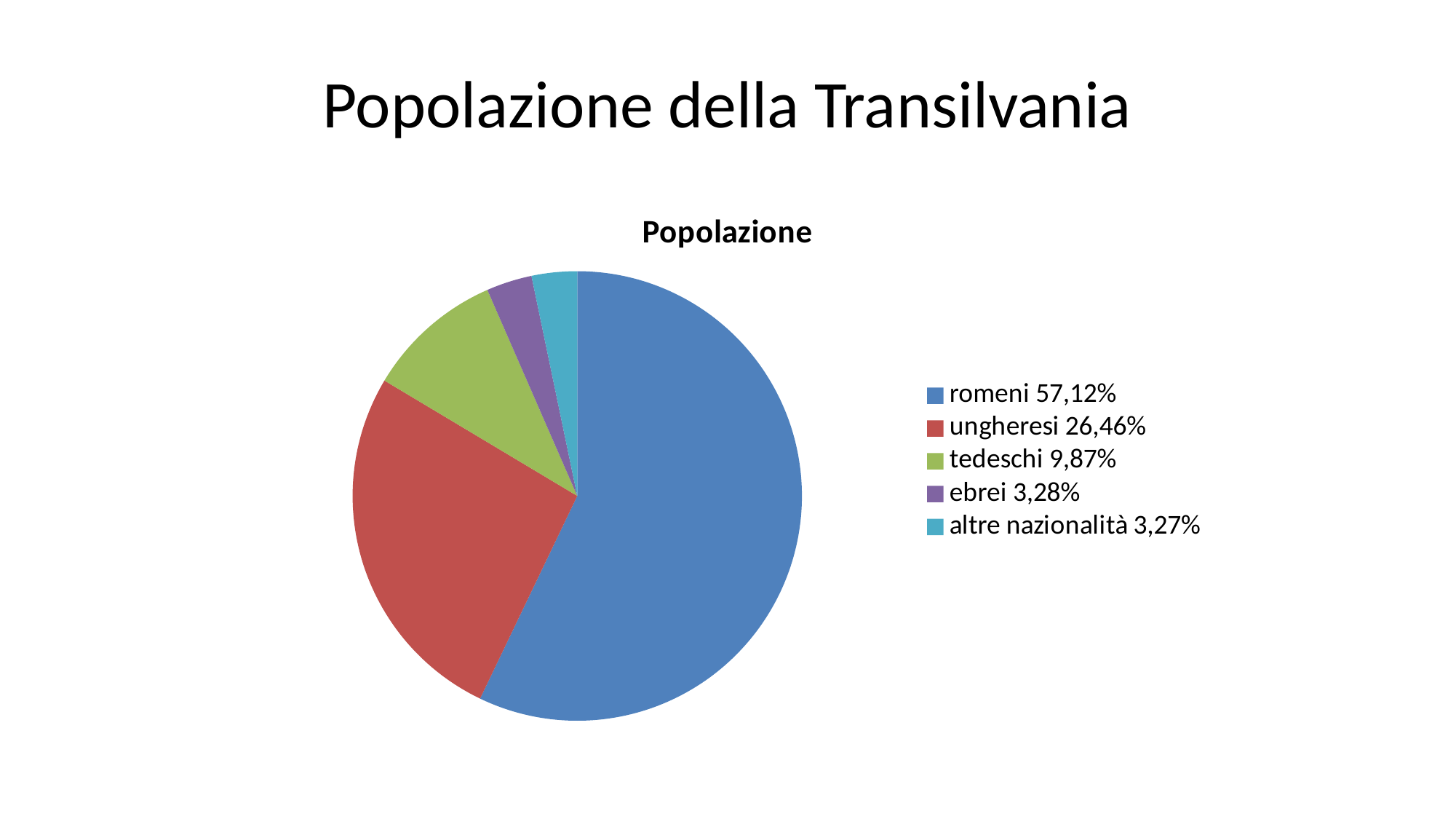
What kind of chart is shown on the slide? pie chart What percentage is shown for ebrei? 3,28% How many slices does the pie chart have? 5 What share of the population is romeni? 57,12% Which is larger, the share for ungheresi or the share for tedeschi? ungheresi What percentage is shown for altre nazionalità? 3,27% What percentage is shown for tedeschi? 9,87% Which group has the largest share of the population? romeni Which group has the smallest share of the population? altre nazionalità What is the title of the chart? Popolazione What is the difference in percentage points between romeni and ungheresi? 30,66% What percentage is shown for ungheresi? 26,46%